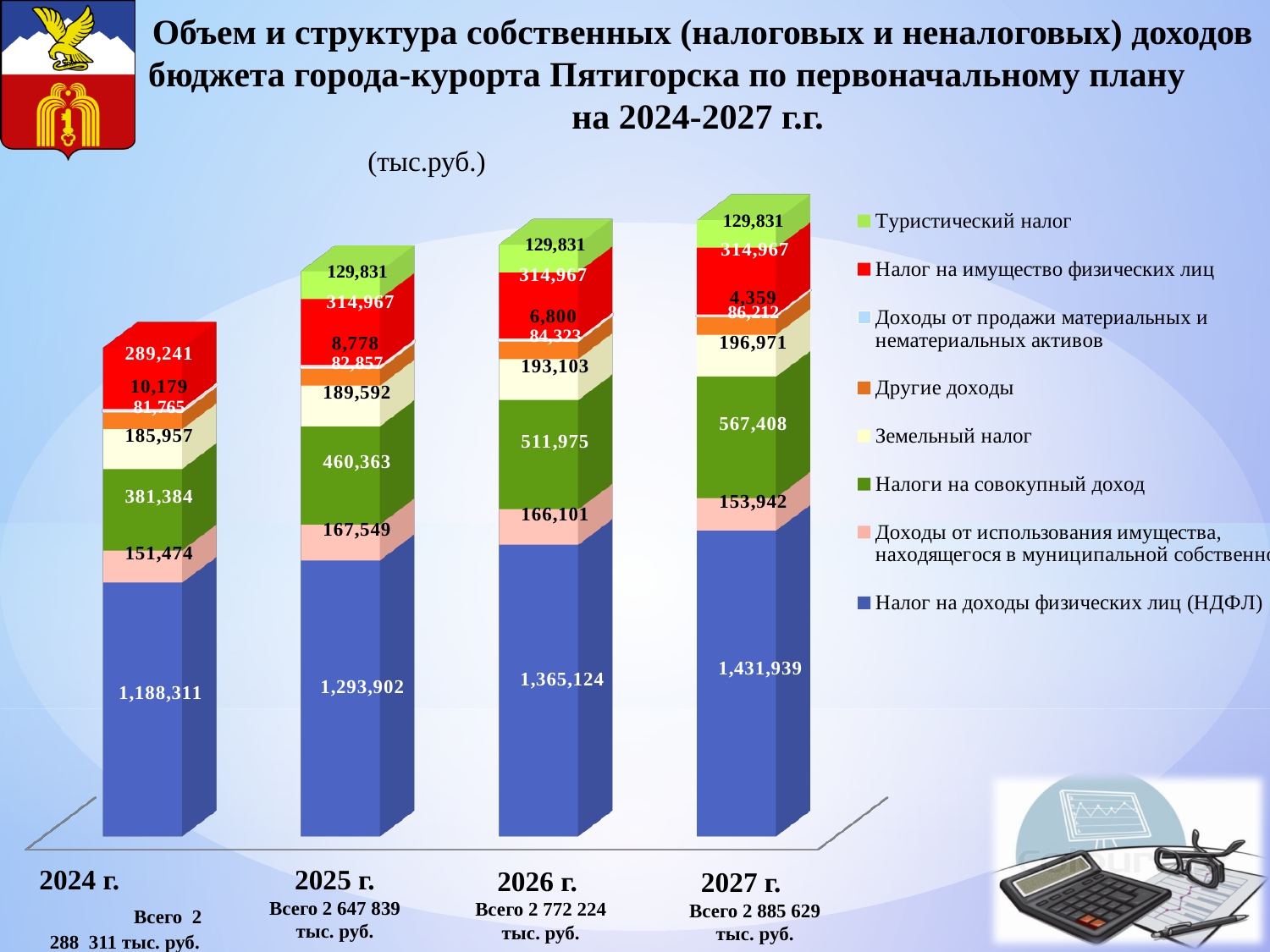
In which year is the value of Налог на доходы физических лиц (НДФЛ) the highest? 2027 г. Which is larger: Доходы от использования имущества for 2025 г. or for 2027 г.? 2025 г. How many series does the legend list? 8 What is the value of Земельный налог for 2024 г.? 185,957 How many years (categories) are shown on the x axis? 4 What is the value of Туристический налог for 2026 г.? 129,831 In which year is the value of Налоги на совокупный доход the lowest? 2024 г. What is the difference between the Налог на имущество физических лиц values for 2025 г. and 2024 г.? 25,726 What is the value of Налог на доходы физических лиц (НДФЛ) for 2027 г.? 1,431,939 What is the value of Налоги на совокупный доход for 2025 г.? 460,363 Does the value of Налог на доходы физических лиц (НДФЛ) rise or fall from 2024 г. to 2027 г.? rise What is the total (Всего) of the stacked bar for 2026 г.? 2 772 224 тыс. руб.